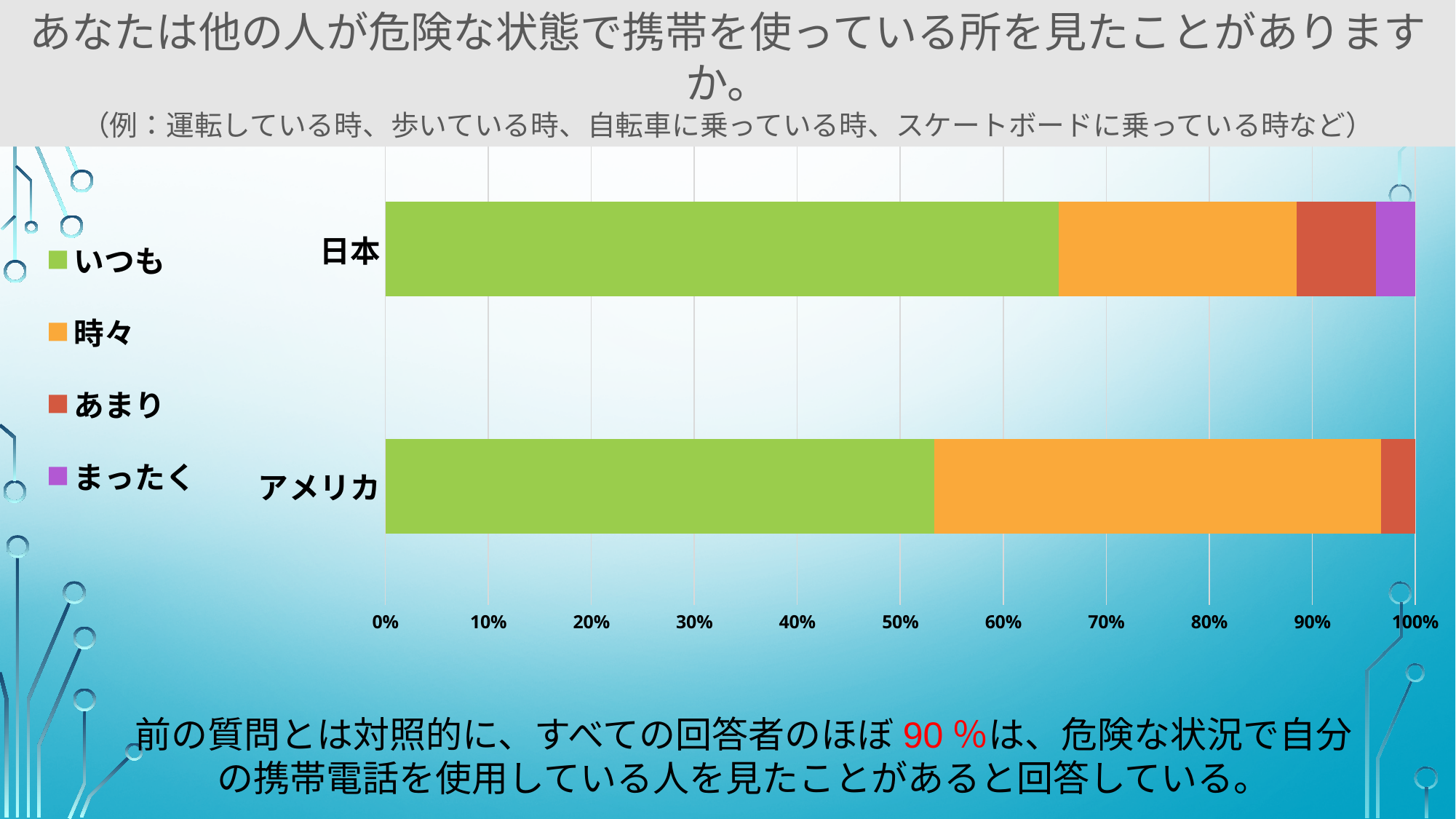
Is the いつも share for アメリカ greater or less than 60%? less Which two categories are shown on the chart's vertical axis? 日本 and アメリカ Which country has the larger いつも share, 日本 or アメリカ? 日本 How many categories (countries) are plotted on the chart? 2 Which country has the larger 時々 share, 日本 or アメリカ? アメリカ Which country's bar includes a まったく segment? 日本 What kind of chart is shown on the slide? bar chart Which legend entry is shown in green? いつも Is the いつも share for アメリカ greater or less than 50%? greater What value does each stacked bar reach on the horizontal axis? 100% Is the いつも share for 日本 greater or less than 60%? greater How many series does the legend list? 4